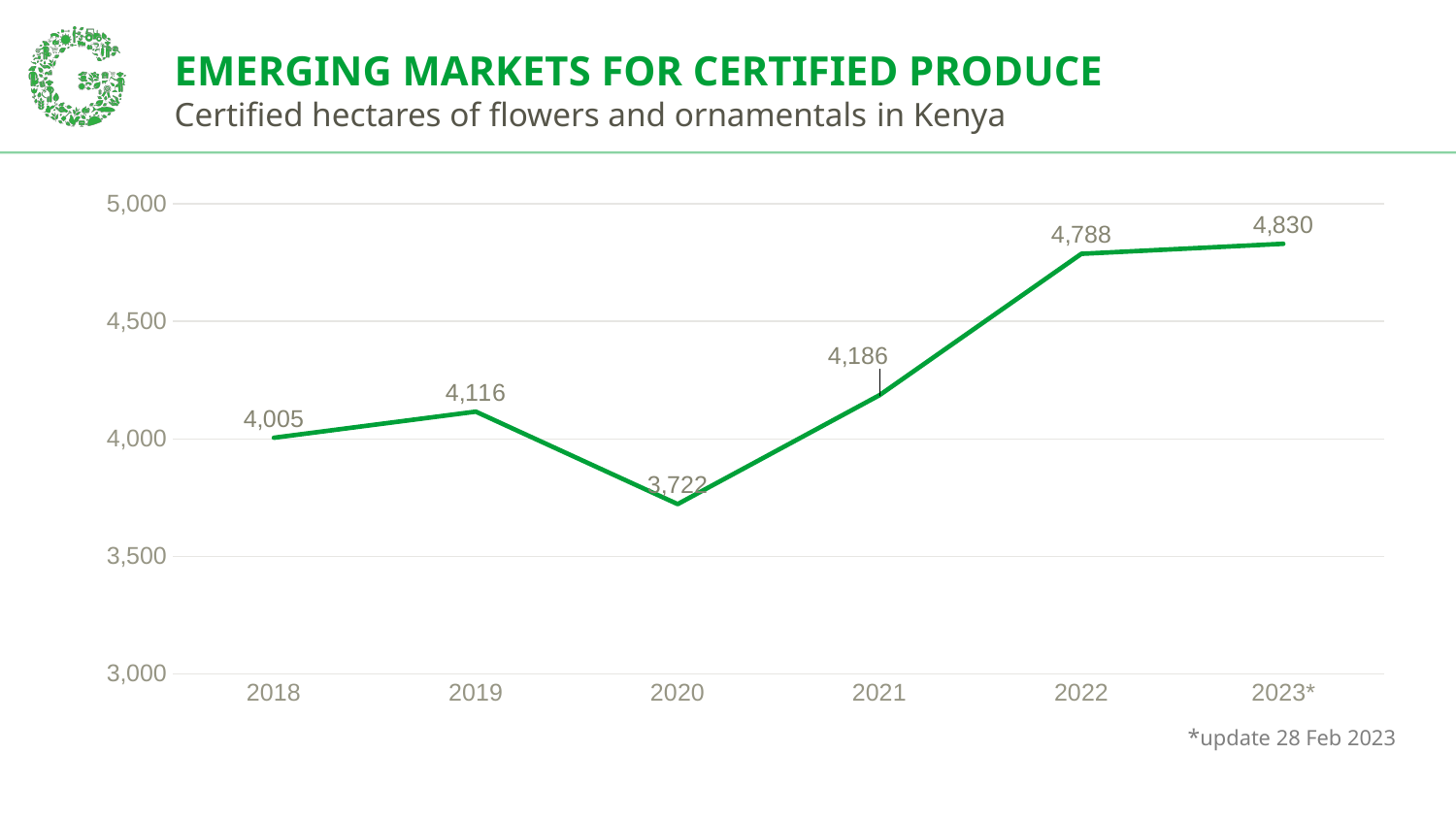
What is the difference between the values for 2019 and 2018? 111 How many years are plotted on the chart? 6 Which year has the highest value of certified hectares? 2023* Which is larger, the value for 2019 or the value for 2020? 2019 What is the value of certified hectares for 2023*? 4,830 Do the values rise or fall from 2020 to 2023*? rise What is the difference between the values for 2022 and 2021? 602 Which year has the lowest value of certified hectares? 2020 What kind of chart is shown on the slide? line chart What is the value of certified hectares for 2020? 3,722 What is the value of certified hectares for 2018? 4,005 Is the value for 2021 greater or less than 4,000? greater